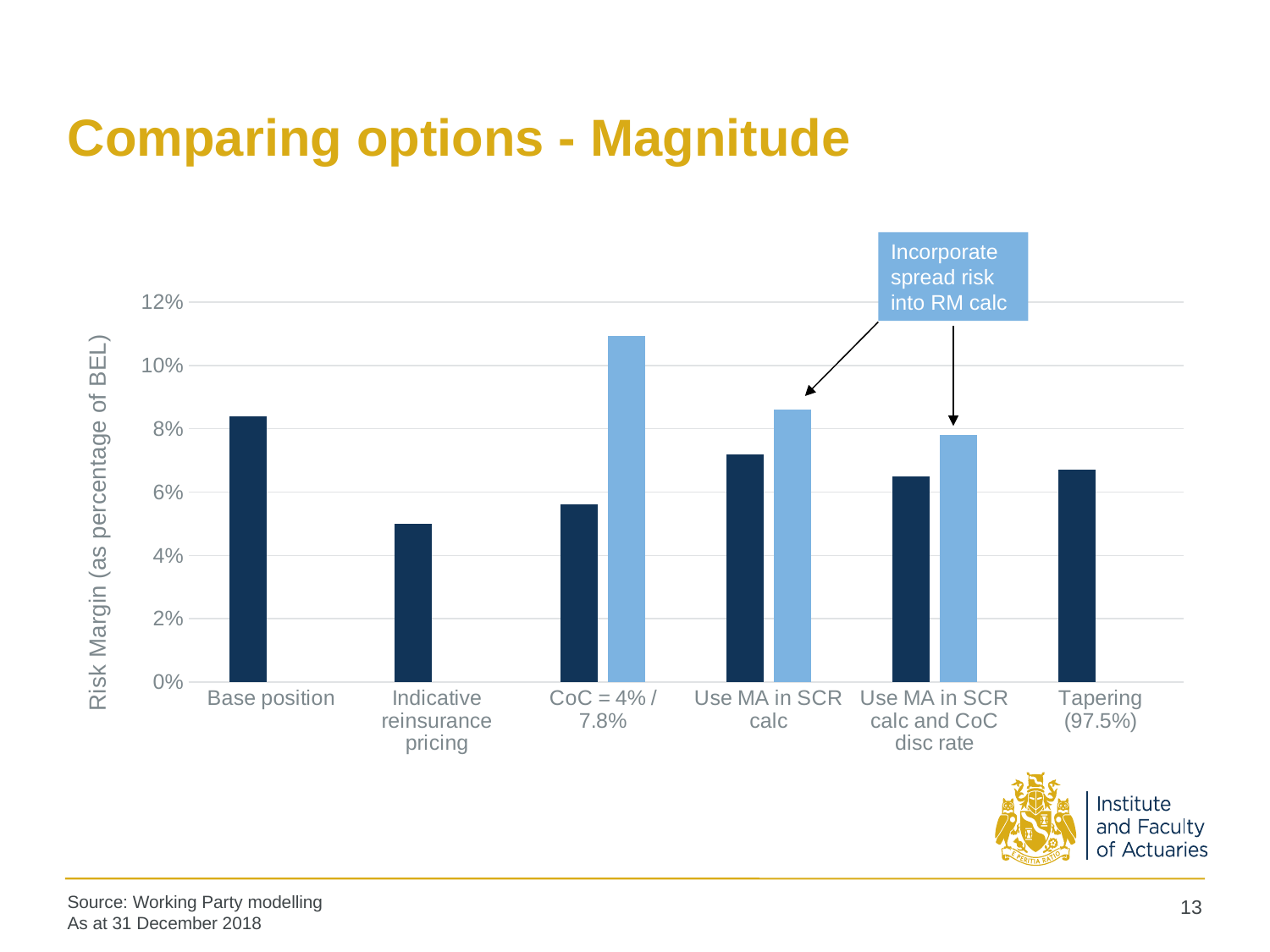
Which category has the shortest bar in the chart? Indicative reinsurance pricing Which is larger, the bar for Base position or the bar for Tapering (97.5%)? Base position For Use MA in SCR calc, which bar is taller, the dark blue bar or the light blue bar? the light blue bar Is the light blue bar for CoC = 4% / 7.8% greater or less than 10%? greater What kind of chart is shown on the slide? bar chart Is the value for Indicative reinsurance pricing greater or less than 6%? less Is the value for Tapering (97.5%) greater or less than 8%? less How many categories are shown along the x axis of the chart? 6 Which category has the tallest bar in the chart? CoC = 4% / 7.8% What is the label on the vertical axis of the chart? Risk Margin (as percentage of BEL)